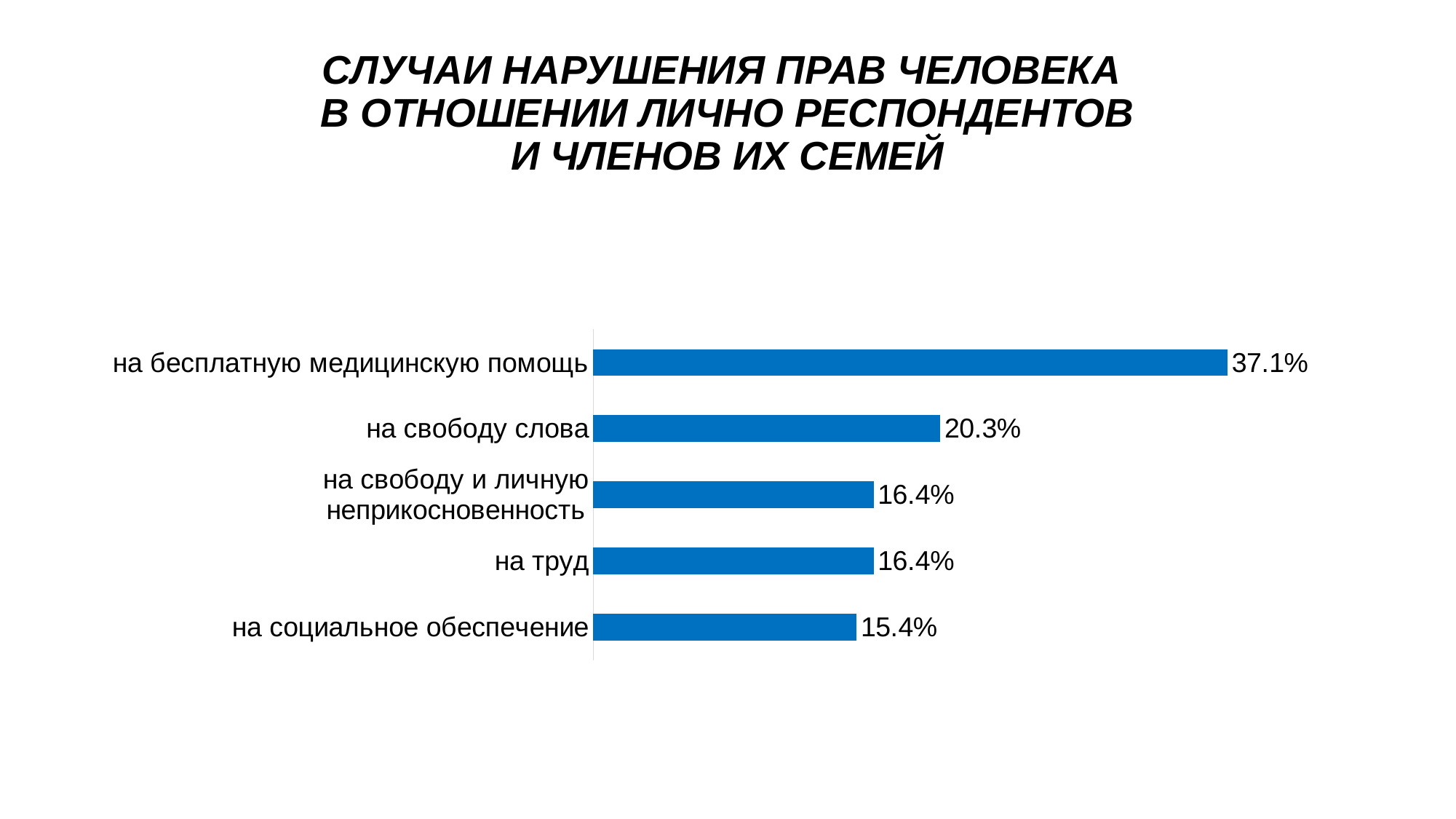
What is the value for "на социальное обеспечение"? 15.4% What is the value for "на свободу слова"? 20.3% Which category has the highest value? на бесплатную медицинскую помощь What is the difference between the values for "на труд" and "на социальное обеспечение"? 1.0% What is the value for "на труд"? 16.4% How many categories are shown in the chart? 5 What is the value for "на бесплатную медицинскую помощь"? 37.1% What is the difference between the values for "на бесплатную медицинскую помощь" and "на свободу слова"? 16.8% Which two categories have the same value? на свободу и личную неприкосновенность and на труд Which category has the lowest value? на социальное обеспечение Which is larger, the value for "на свободу слова" or the value for "на труд"? на свободу слова What kind of chart is shown on the slide? bar chart